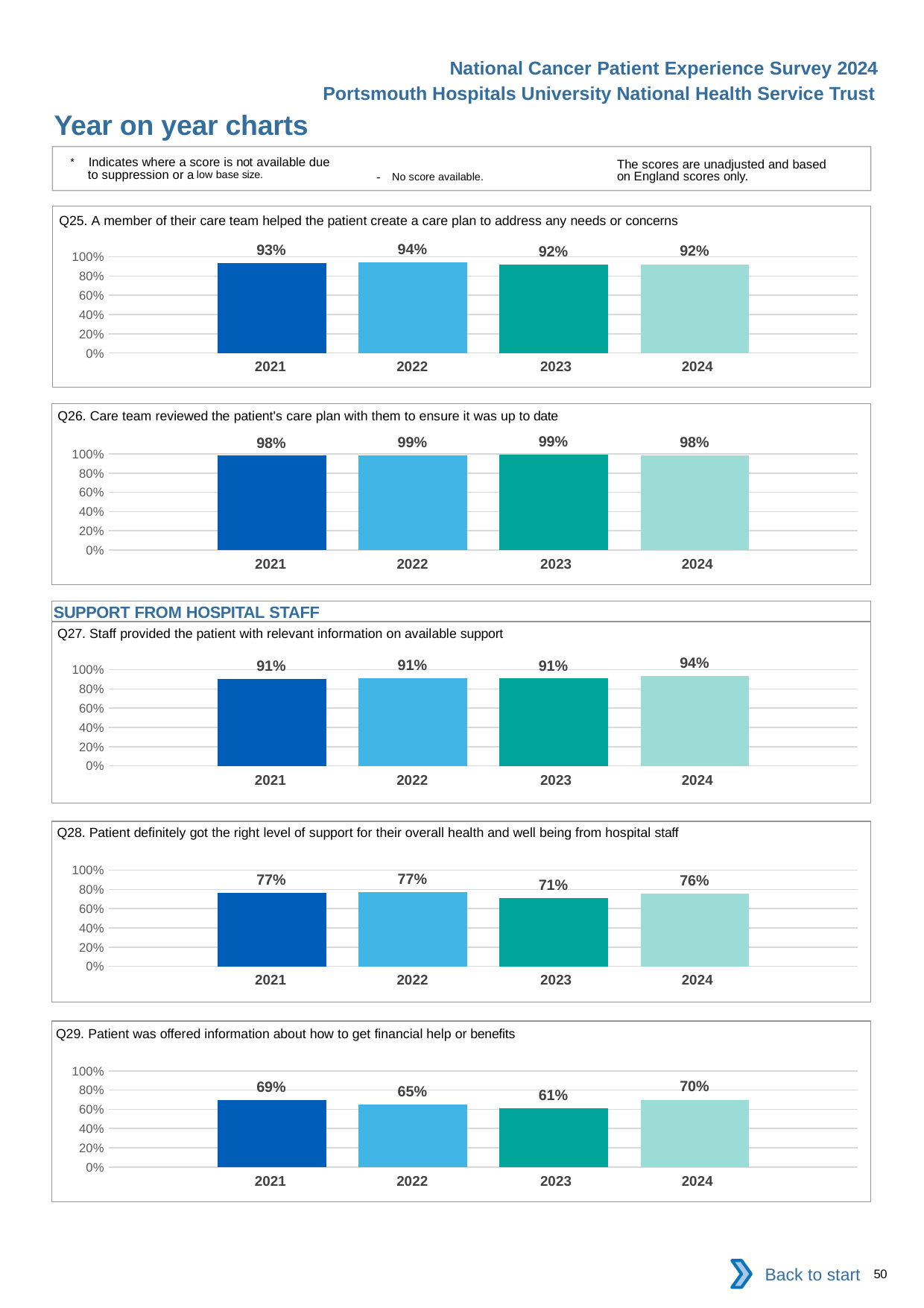
In the Q29 chart, how many years are plotted? 4 What kind of chart is the Q27 chart? bar chart In the Q27 chart, which year has the highest value? 2024 In the Q29 chart, what is the value for 2021? 69% In the Q29 chart, what is the difference between the 2024 value and the 2023 value? 9% In the Q28 chart, which year has the lowest value? 2023 In the Q29 chart, is the value for 2023 greater or less than 80%? less In the Q25 chart, what is the value for 2022? 94% In the Q26 chart, what is the value for 2024? 98% What is the section heading shown above the Q27 chart? SUPPORT FROM HOSPITAL STAFF In the Q28 chart, what is the difference between the 2022 value and the 2024 value? 1% In the Q28 chart, which is larger, the value for 2021 or the value for 2023? 2021